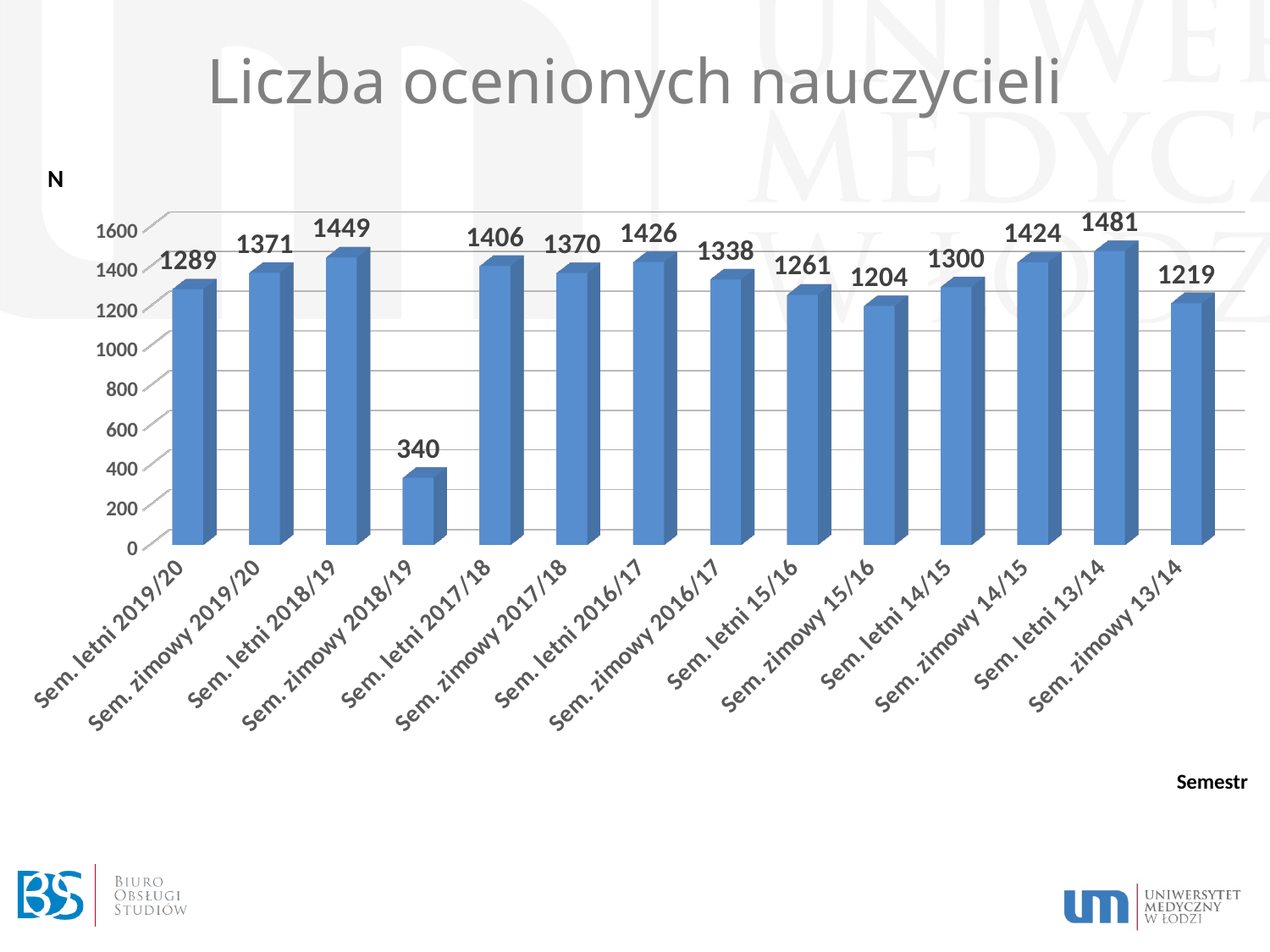
What is the value for Sem. zimowy 2018/19? 340 What is the value for Sem. letni 2019/20? 1289 What is the value for Sem. zimowy 15/16? 1204 Which is larger, the value for Sem. letni 2017/18 or Sem. zimowy 2017/18? Sem. letni 2017/18 What is the label of the x axis? Semestr Which semester has the lowest value? Sem. zimowy 2018/19 How many semesters are shown on the chart? 14 Is the value for Sem. zimowy 13/14 greater or less than 1400? less What is the difference between the values for Sem. letni 2018/19 and Sem. zimowy 2018/19? 1109 What is the title of the chart? Liczba ocenionych nauczycieli Which semester has the highest value? Sem. letni 13/14 What kind of chart is shown on the slide? bar chart